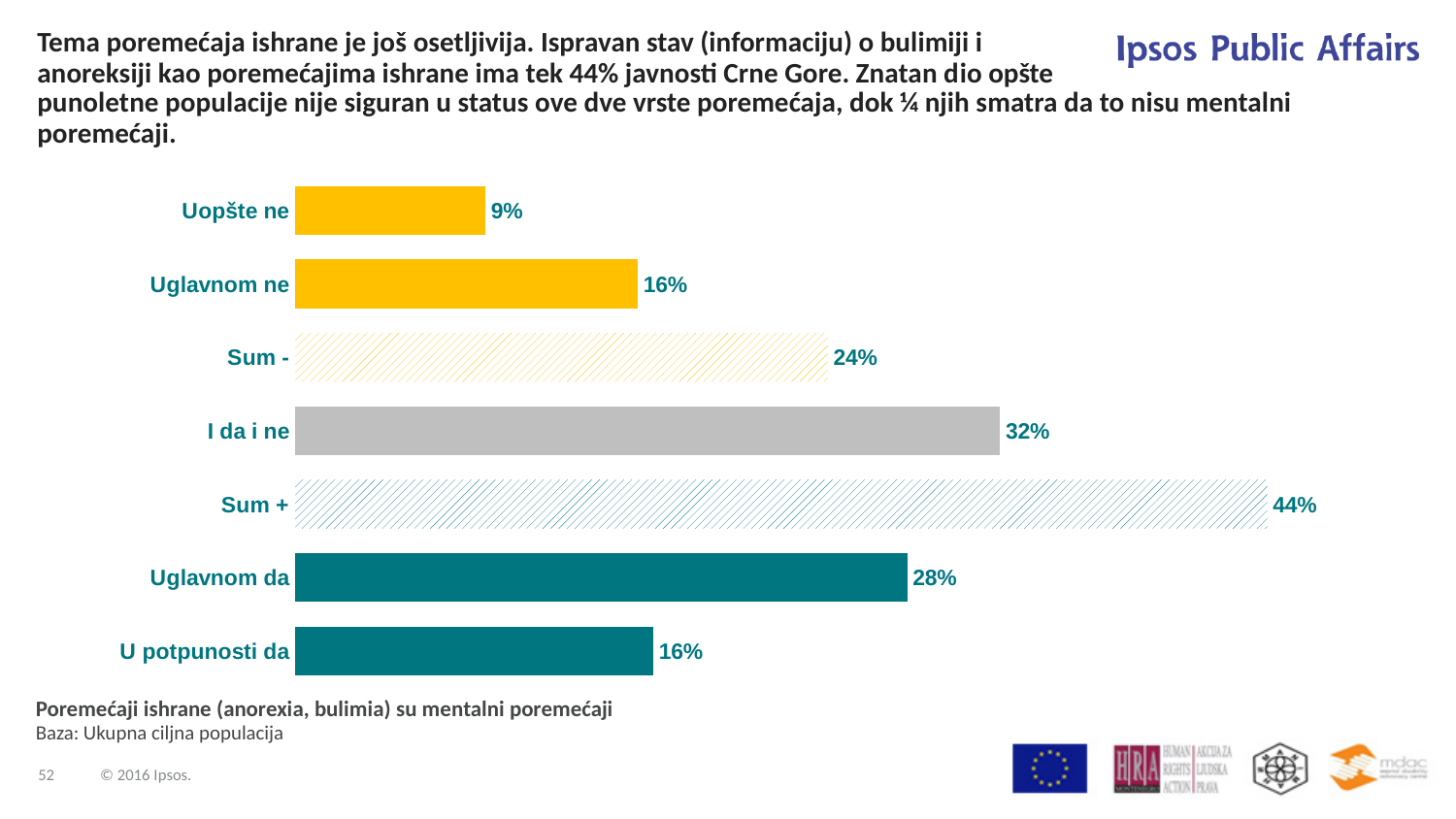
Which is larger, "I da i ne" or "Uglavnom da"? I da i ne What is the title text shown below the chart? Poremećaji ishrane (anorexia, bulimia) su mentalni poremećaji What is the value for "Uglavnom da"? 28% What is the value for "Uopšte ne"? 9% What is the value for "Sum +"? 44% What is the difference between "Uglavnom da" and "Uglavnom ne"? 12% Which category has the lowest value? Uopšte ne Which category has the highest value? Sum + How many bars are shown in the chart? 7 What is the value for "I da i ne"? 32% What is the difference between "Sum +" and "Sum -"? 20% What kind of chart is shown on the slide? Bar chart